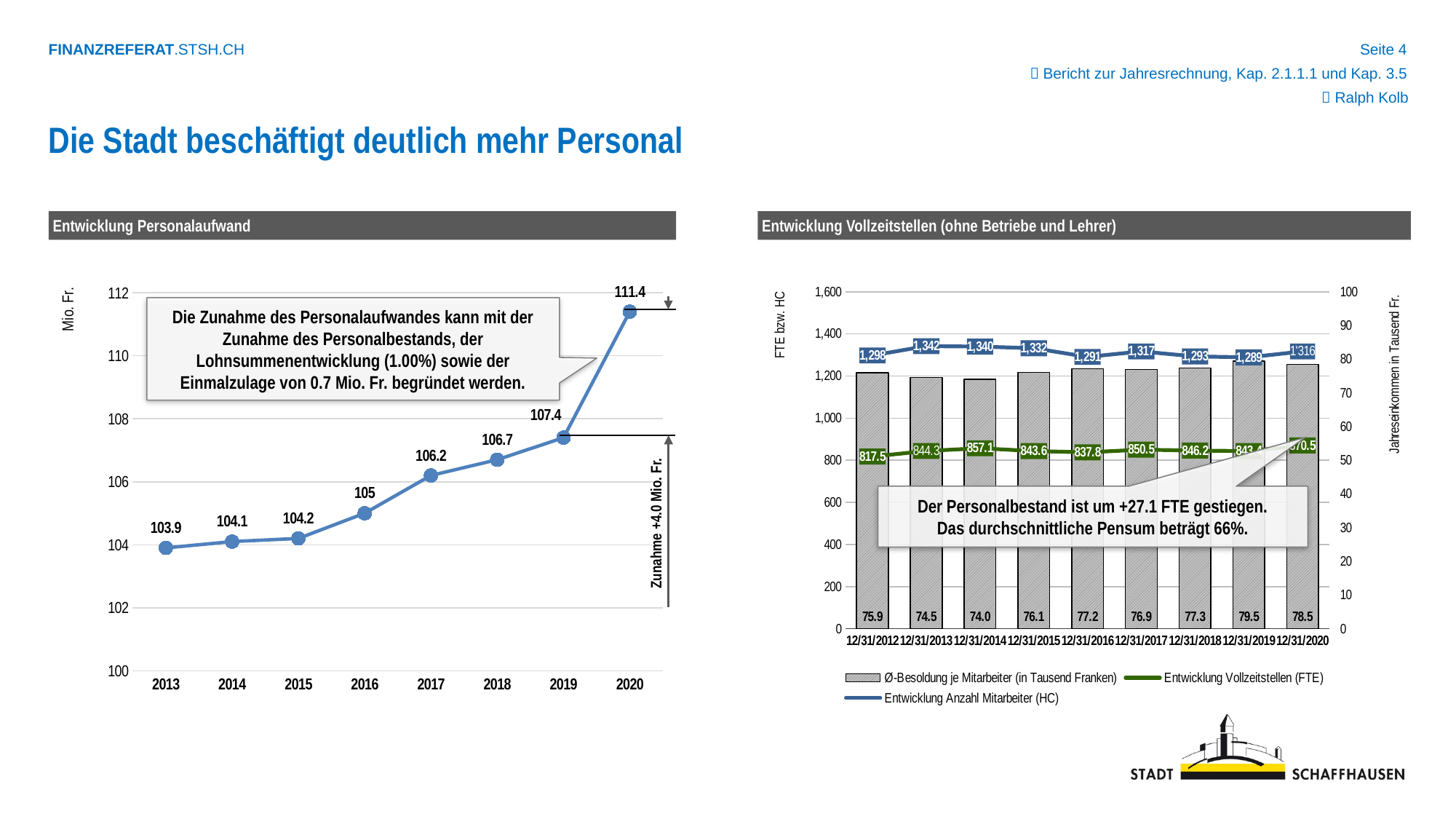
How many years are plotted in the chart 'Entwicklung Personalaufwand'? 8 In the chart 'Entwicklung Personalaufwand', which year has the highest value? 2020 In the chart 'Entwicklung Personalaufwand', do the values rise or fall from 2013 to 2020? rise In the chart 'Entwicklung Vollzeitstellen (ohne Betriebe und Lehrer)', what is the Ø-Besoldung je Mitarbeiter value for 12/31/2020? 78.5 In the chart 'Entwicklung Personalaufwand', what is the difference between the values for 2020 and 2019? 4.0 In the chart 'Entwicklung Personalaufwand', what is the value for 2013? 103.9 In the chart 'Entwicklung Personalaufwand', which year has the lowest value? 2013 In the chart 'Entwicklung Vollzeitstellen (ohne Betriebe und Lehrer)', what is the Entwicklung Anzahl Mitarbeiter (HC) value for 12/31/2013? 1,342 How many series does the legend of the chart 'Entwicklung Vollzeitstellen (ohne Betriebe und Lehrer)' list? 3 In the chart 'Entwicklung Personalaufwand', what is the value for 2020? 111.4 In the chart 'Entwicklung Vollzeitstellen (ohne Betriebe und Lehrer)', which date has the highest Ø-Besoldung je Mitarbeiter bar? 12/31/2019 What kind of chart is 'Entwicklung Personalaufwand'? line chart